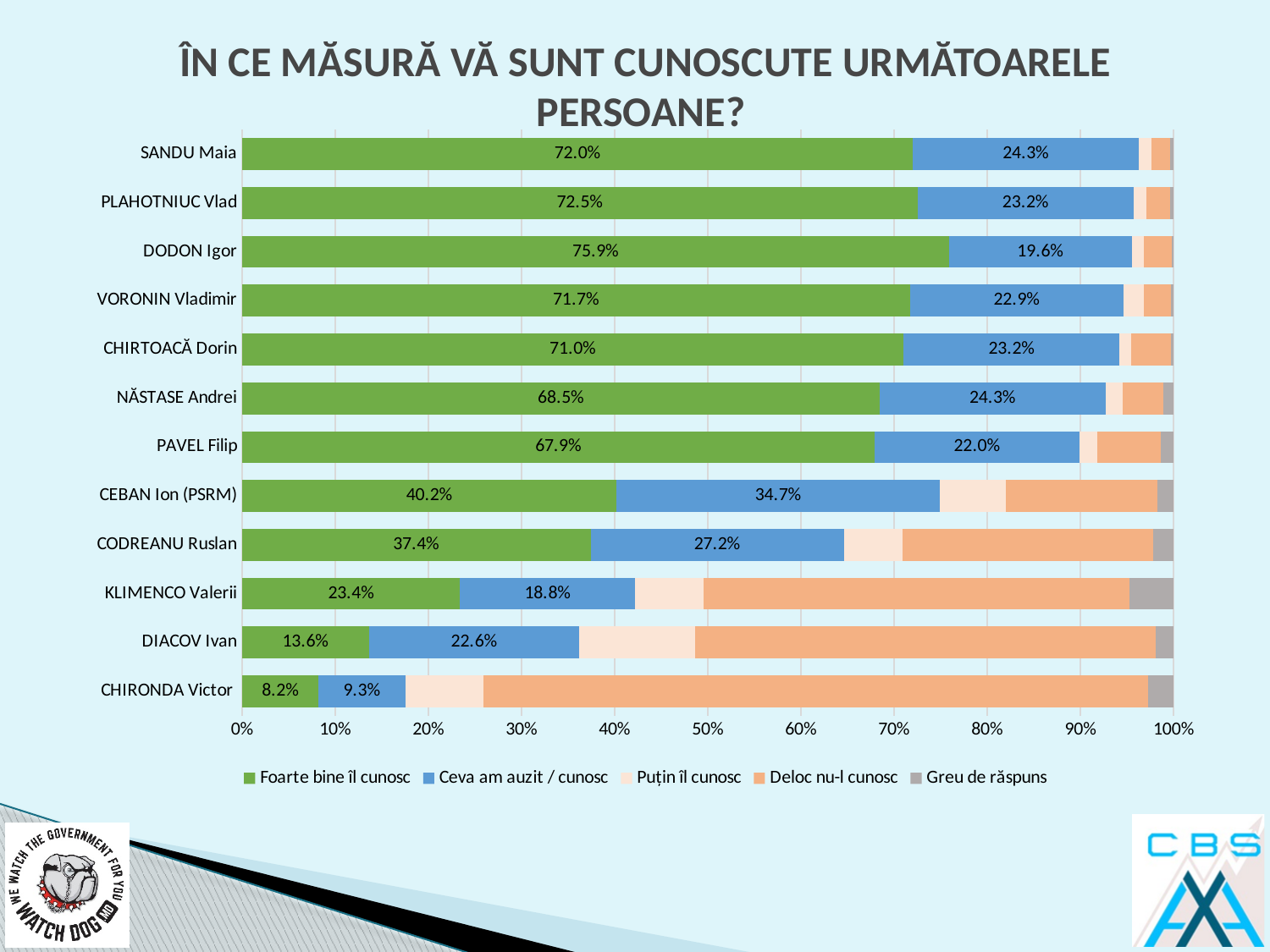
Which person has the lowest 'Foarte bine îl cunosc' value? CHIRONDA Victor What is the 'Ceva am auzit / cunosc' value for CEBAN Ion (PSRM)? 34.7% What is the difference between the 'Foarte bine îl cunosc' values for DODON Igor and SANDU Maia? 3.9 percentage points What kind of chart is shown on the slide? Stacked bar chart How many series does the legend list? 5 What is the 'Foarte bine îl cunosc' value for DIACOV Ivan? 13.6% Is the 'Foarte bine îl cunosc' value for KLIMENCO Valerii greater or less than 20%? greater Which has the larger 'Ceva am auzit / cunosc' value, KLIMENCO Valerii or DIACOV Ivan? DIACOV Ivan What is the first entry in the chart's legend? Foarte bine îl cunosc What is the 'Foarte bine îl cunosc' value for DODON Igor? 75.9% How many people are listed on the chart? 12 Which person has the highest 'Foarte bine îl cunosc' value? DODON Igor